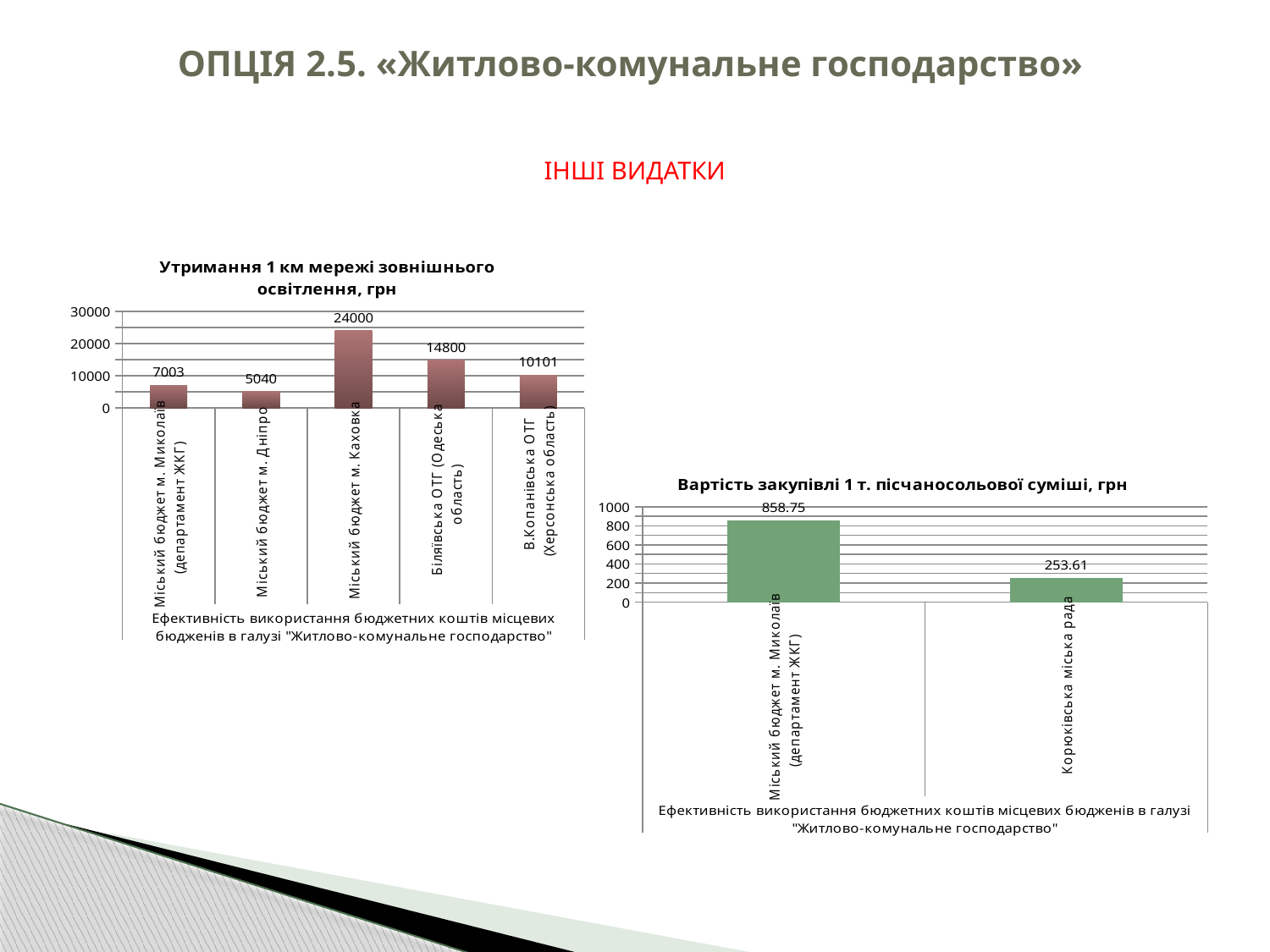
In the chart 'Утримання 1 км мережі зовнішнього освітлення, грн', what is the value for Міський бюджет м. Дніпро? 5040 What type of chart is 'Вартість закупівлі 1 т. пісчаносольової суміші, грн'? Bar chart In the chart 'Утримання 1 км мережі зовнішнього освітлення, грн', which category has the highest value? Міський бюджет м. Каховка In the chart 'Вартість закупівлі 1 т. пісчаносольової суміші, грн', what is the difference between the two values? 605.14 In the chart 'Утримання 1 км мережі зовнішнього освітлення, грн', what is the value for Біляївська ОТГ (Одеська область)? 14800 In the chart 'Вартість закупівлі 1 т. пісчаносольової суміші, грн', what is the value for Корюківська міська рада? 253.61 In the chart 'Утримання 1 км мережі зовнішнього освітлення, грн', what is the difference between the values for Міський бюджет м. Каховка and Біляївська ОТГ (Одеська область)? 9200 In the chart 'Вартість закупівлі 1 т. пісчаносольової суміші, грн', what is the value for Міський бюджет м. Миколаїв (департамент ЖКГ)? 858.75 In the chart 'Утримання 1 км мережі зовнішнього освітлення, грн', what is the value for Міський бюджет м. Каховка? 24000 In the chart 'Утримання 1 км мережі зовнішнього освітлення, грн', which is larger: the value for Міський бюджет м. Миколаїв (департамент ЖКГ) or for В.Копанівська ОТГ (Херсонська область)? В.Копанівська ОТГ (Херсонська область) In the chart 'Утримання 1 км мережі зовнішнього освітлення, грн', which category has the lowest value? Міський бюджет м. Дніпро In the chart 'Утримання 1 км мережі зовнішнього освітлення, грн', how many categories are shown? 5